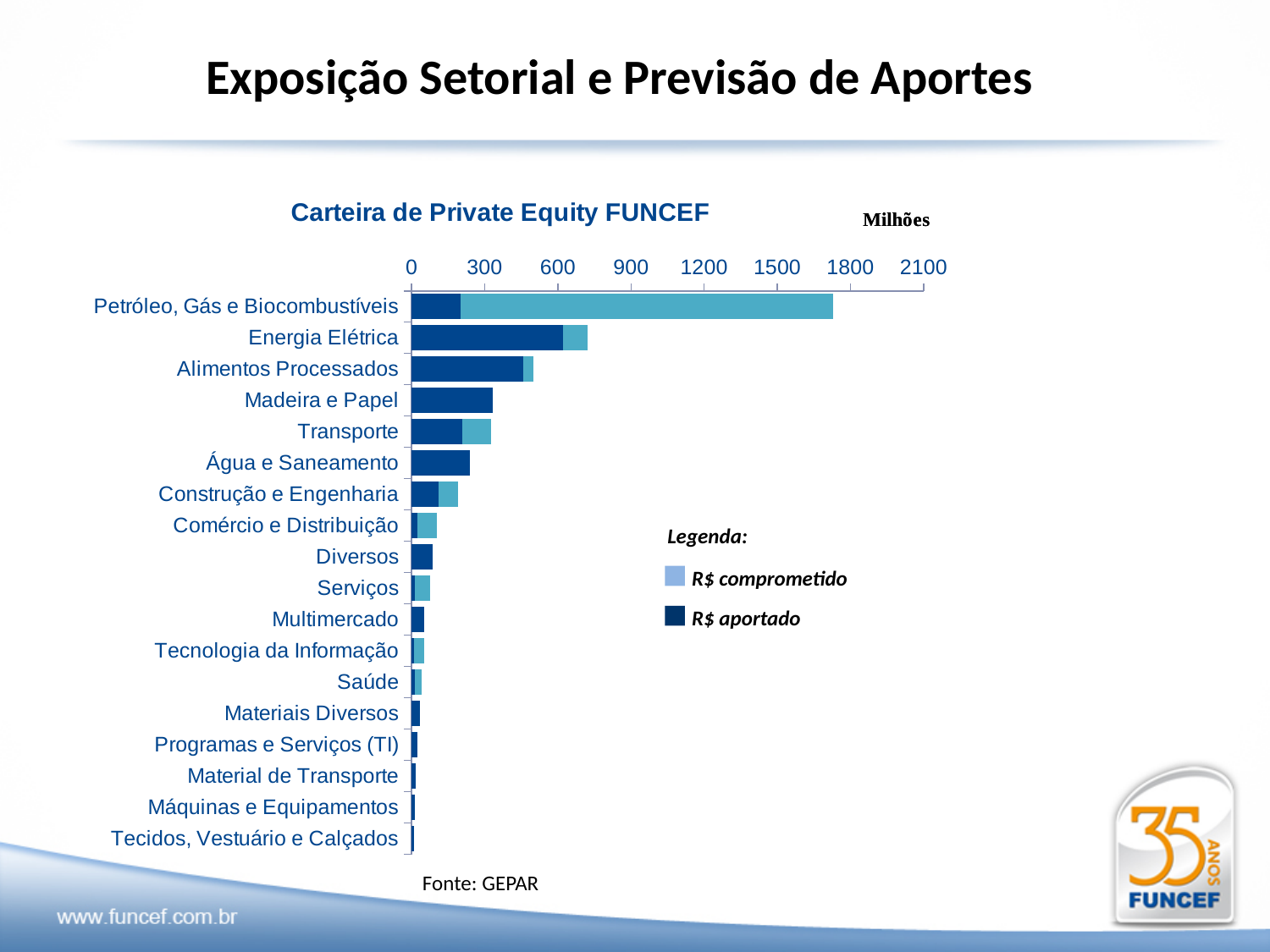
Is the total bar for Alimentos Processados greater or less than 600? less Is the total bar for Água e Saneamento greater or less than 300? less What kind of chart is shown on the slide? Bar chart Which has the longer total bar, Madeira e Papel or Água e Saneamento? Madeira e Papel How many sectors (categories) are plotted in the chart? 18 Is the total bar for Petróleo, Gás e Biocombustíveis greater or less than 1500? greater Which legend entry is shown in the darker blue colour? R$ aportado What is the title of the chart? Carteira de Private Equity FUNCEF Which sector has the longest bar in the chart? Petróleo, Gás e Biocombustíveis How many series does the legend list? 2 Which has the longer total bar, Energia Elétrica or Alimentos Processados? Energia Elétrica